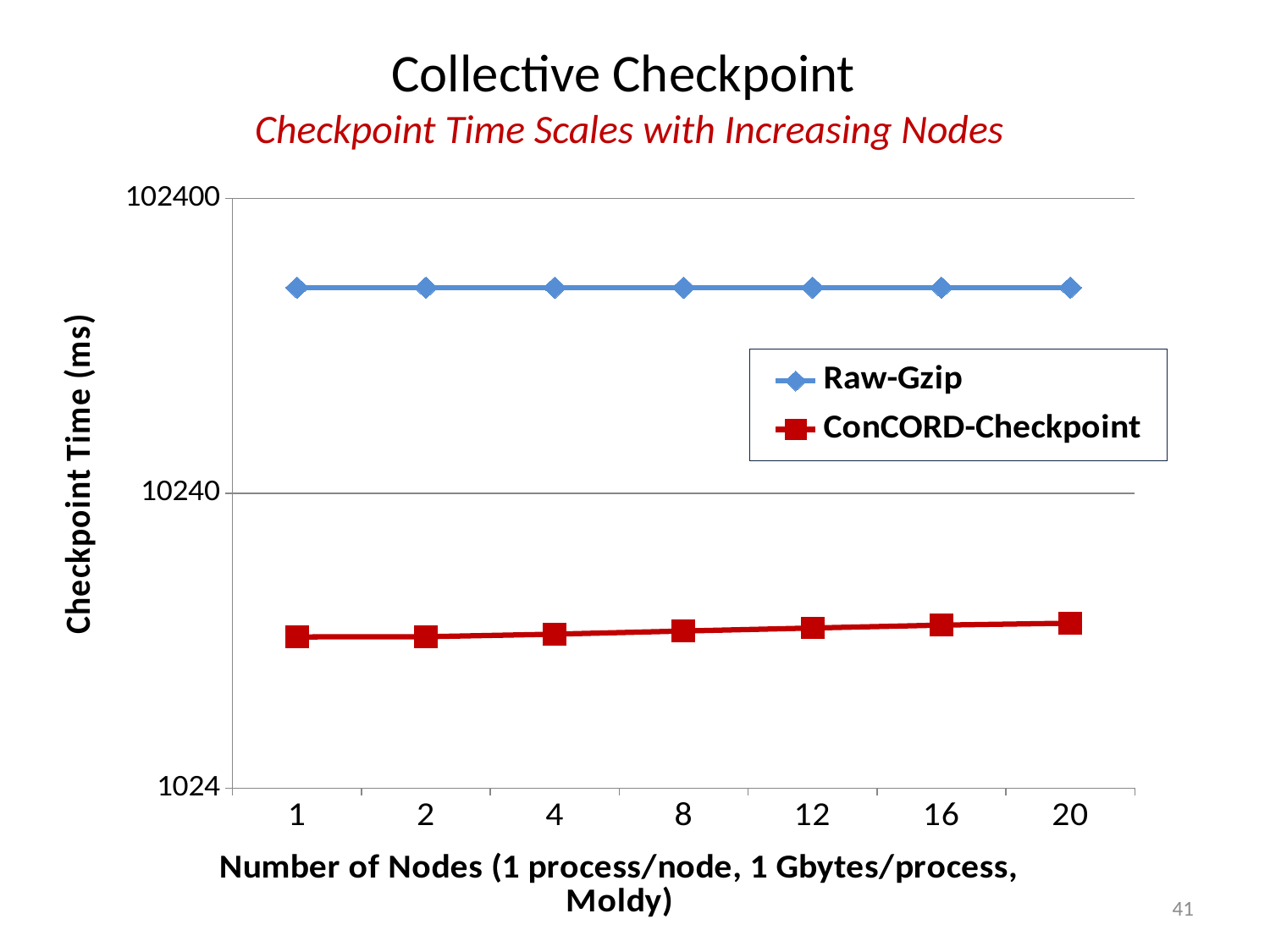
Is the checkpoint time for Raw-Gzip at 1 node greater or less than 10240? greater Does the ConCORD-Checkpoint line rise or fall as the number of nodes increases? Rises slightly Which series has the higher checkpoint time at 8 nodes, Raw-Gzip or ConCORD-Checkpoint? Raw-Gzip Does the Raw-Gzip line rise, fall, or stay flat as the number of nodes increases? Stays flat Is the checkpoint time for ConCORD-Checkpoint at 20 nodes greater or less than 10240? less How many series does the legend list? 2 Which series is drawn in red with square markers? ConCORD-Checkpoint How many node counts are plotted along the x axis? 7 What kind of chart is shown on the slide? Line chart What is the label of the y axis? Checkpoint Time (ms) Is the checkpoint time for Raw-Gzip at 16 nodes greater or less than 102400? less Which series has the lower checkpoint time at 20 nodes? ConCORD-Checkpoint